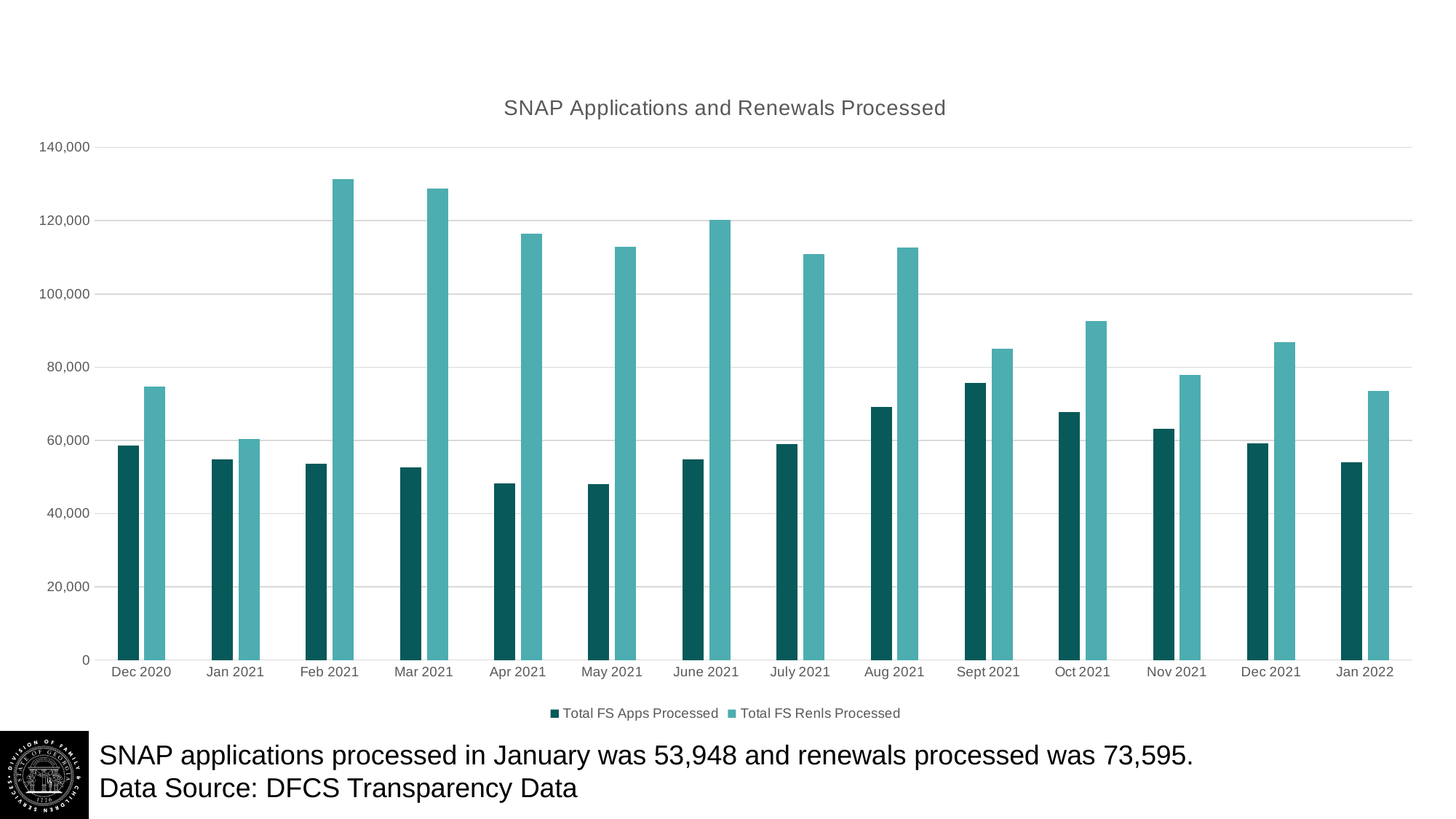
Which is larger: Total FS Renls Processed in Oct 2021 or in Nov 2021? Oct 2021 How many months are shown along the x axis? 14 What is the title of the chart? SNAP Applications and Renewals Processed What kind of chart is shown on the slide? Bar chart What was the value of Total FS Renls Processed for Jan 2022? 73,595 Is the value of Total FS Renls Processed for Feb 2021 greater or less than 120,000? greater Do the values for Total FS Apps Processed rise or fall from Sept 2021 to Jan 2022? Fall How many series does the legend list? 2 What is the difference between renewals processed and applications processed in Jan 2022? 19,647 Which month has the lowest value for Total FS Renls Processed? Jan 2021 Which month has the highest value for Total FS Apps Processed? Sept 2021 What was the value of Total FS Apps Processed for Jan 2022? 53,948